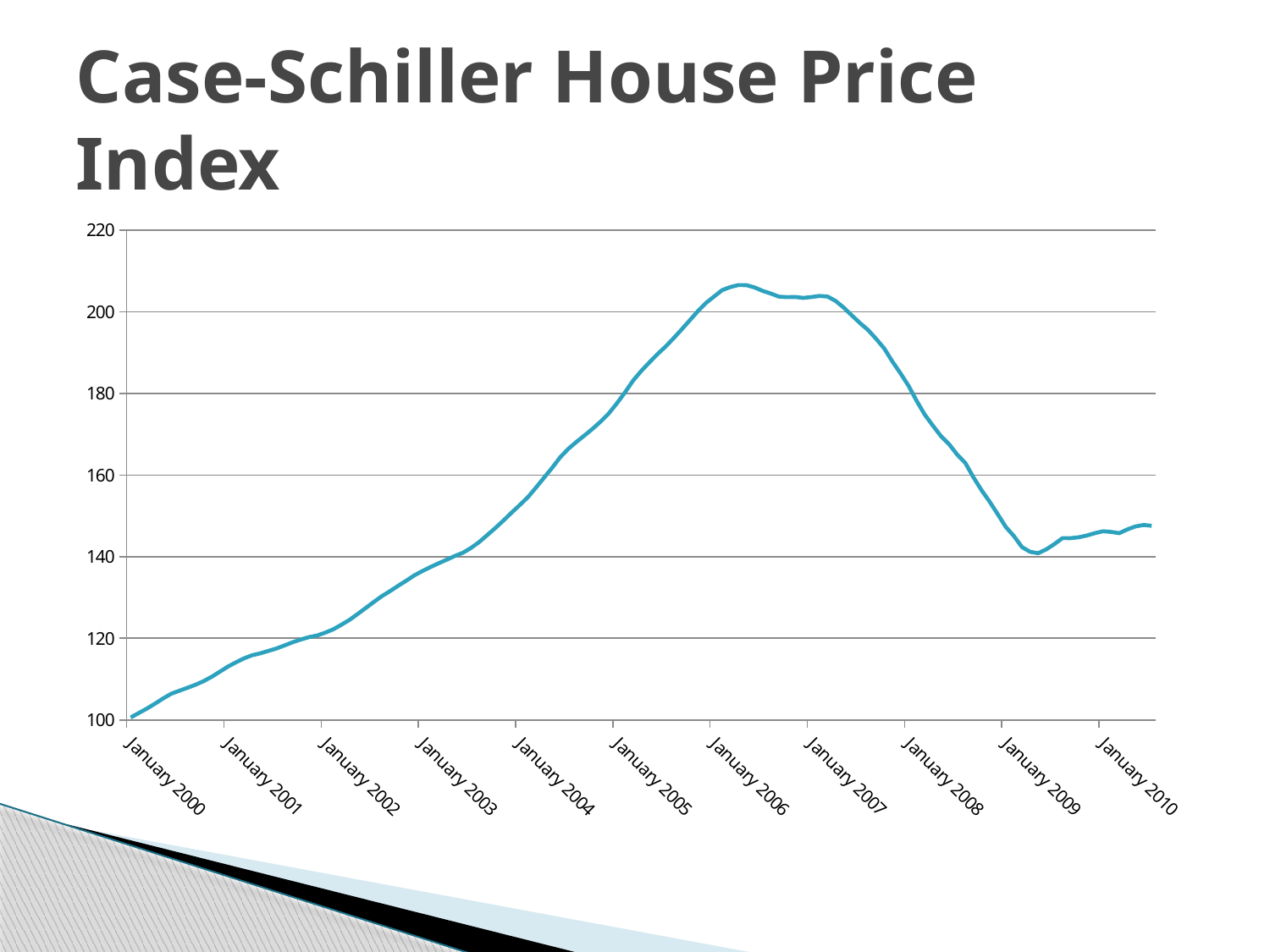
In which year does the index reach its highest point? 2006 Does the index rise or fall between January 2007 and January 2009? fall Is the value for January 2010 greater or less than 160? less Does the index rise or fall between January 2000 and January 2006? rise Is the value for January 2004 greater or less than 160? less Is the value for January 2002 greater or less than 140? less What kind of chart is shown on the slide? line chart What is the title of the chart on the slide? Case-Schiller House Price Index How many January labels are shown along the x axis? 11